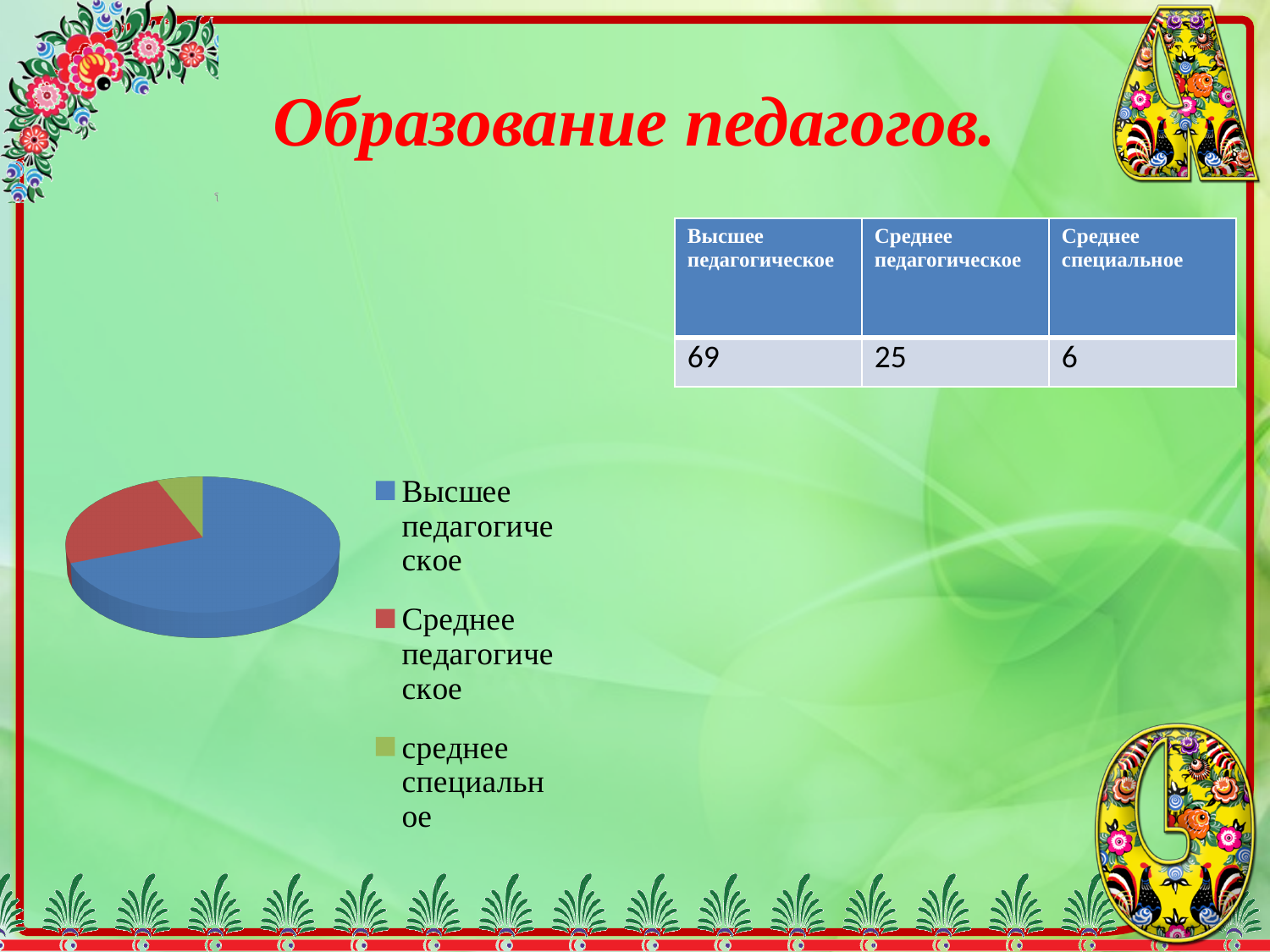
How many slices does the pie chart have? 3 Which category has the smallest slice in the pie chart? среднее специальное Which slice is larger: Среднее педагогическое or среднее специальное? Среднее педагогическое What colour is the slice for Высшее педагогическое in the pie chart? blue Which category has the largest slice in the pie chart? Высшее педагогическое What is the difference between the values for Высшее педагогическое and Среднее педагогическое? 44 What kind of chart is shown on the slide? pie chart What value is given on the slide for Высшее педагогическое? 69 What value is given on the slide for Среднее педагогическое? 25 How many entries does the legend of the pie chart list? 3 What share of the pie does Высшее педагогическое represent, based on the values shown on the slide? 69% What value is given on the slide for Среднее специальное? 6